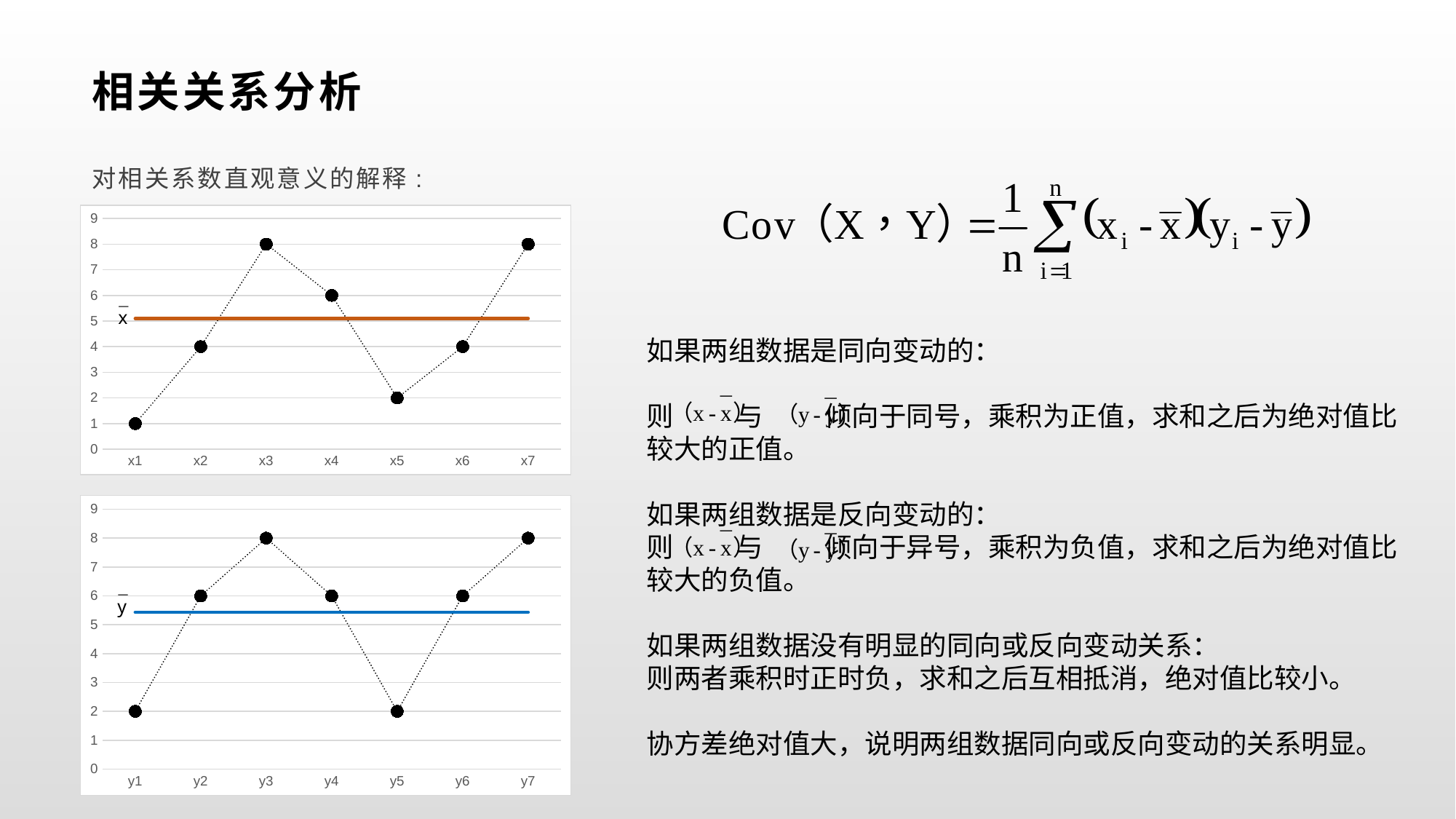
How many data points are plotted in the bottom chart? 7 In the top chart, what is the value at x5? 2 What kind of chart is the top chart on the slide? line chart In the top chart, what is the value at x3? 8 In the top chart, which is larger, the value at x2 or the value at x4? x4 In the bottom chart, what is the value at y4? 6 In the top chart, which point has the lowest value? x1 In the top chart, what is the difference between the values at x3 and x1? 7 In the bottom chart, what is the value at y1? 2 In the top chart, what is the value at x1? 1 In the top chart, is the horizontal mean line (x̄) greater or less than 6? less In the bottom chart, is the horizontal mean line (ȳ) greater or less than 5? greater